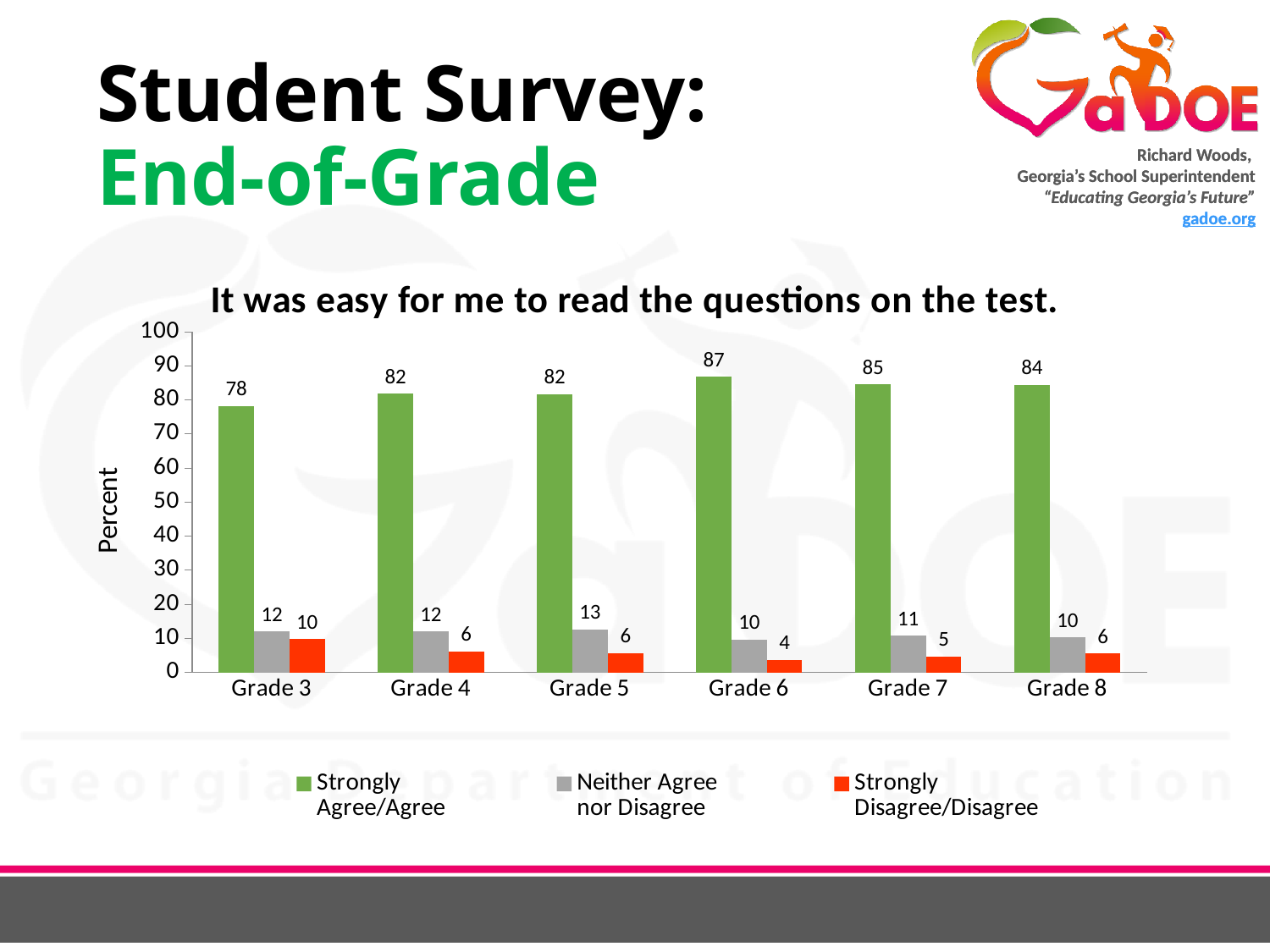
Which grade has the lowest Strongly Agree/Agree value? Grade 3 What kind of chart is shown on the slide? Bar chart What is the label on the y axis? Percent How many grade categories are shown on the x axis? 6 How many series does the legend list? 3 What is the Strongly Disagree/Disagree value for Grade 6? 4 What is the difference between the Strongly Agree/Agree values for Grade 6 and Grade 3? 9 What is the title of the chart? It was easy for me to read the questions on the test. Which grade has the highest Strongly Agree/Agree value? Grade 6 Which is larger, the Strongly Disagree/Disagree value for Grade 3 or for Grade 7? Grade 3 What is the Neither Agree nor Disagree value for Grade 5? 13 What is the Strongly Agree/Agree value for Grade 3? 78